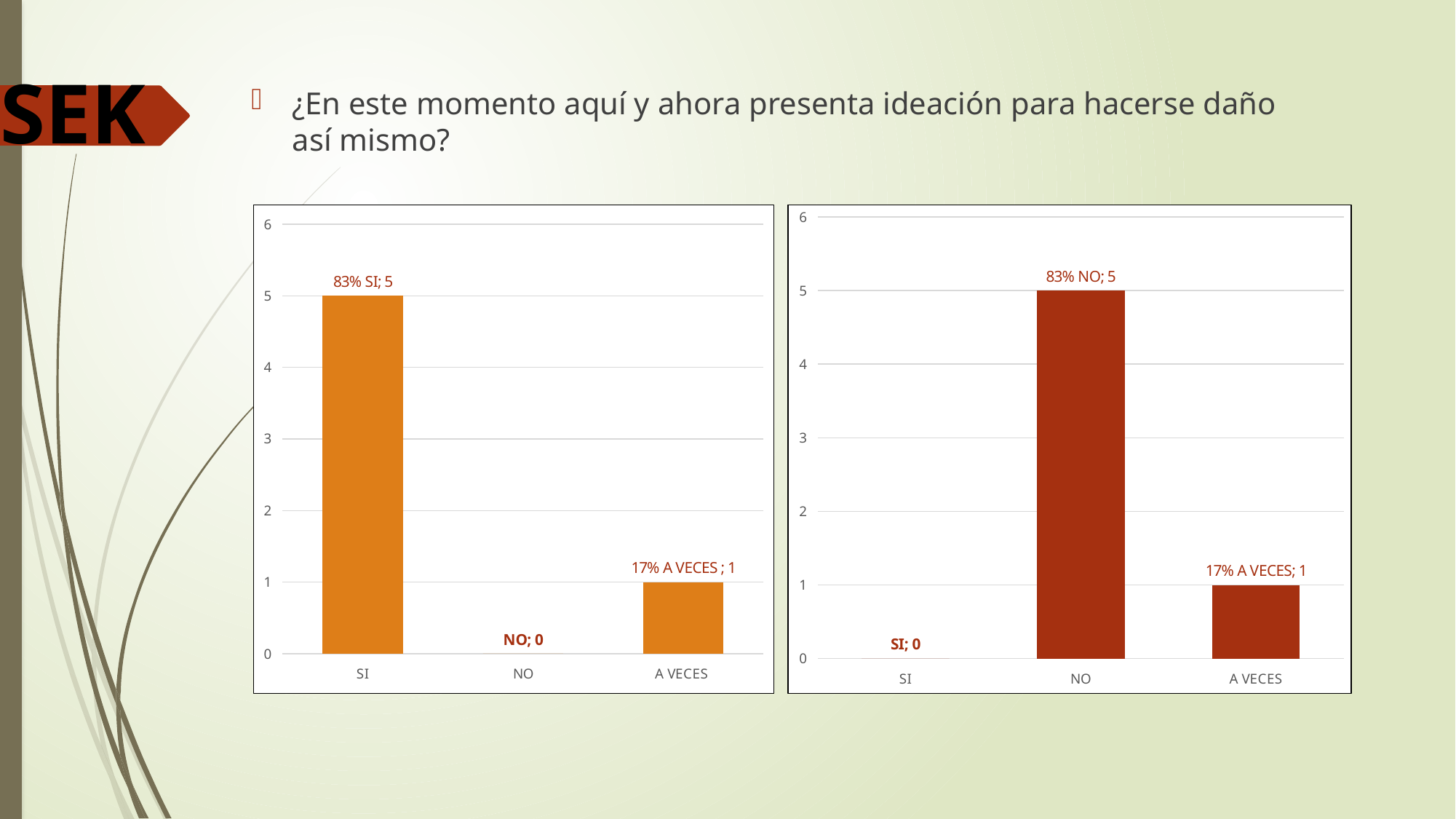
In the left chart, what is the value for A VECES? 1 In the right chart, which category has the lowest value? SI In the left chart, which category has the highest value? SI In the left chart, what is the value for SI? 5 What kind of chart is the left chart? bar chart In the left chart, what is the difference between the values for SI and A VECES? 4 How many categories are shown on the x axis of the right chart? 3 What colour are the bars in the right chart? dark red In the right chart, what is the value for SI? 0 In the left chart, what percentage is shown in the data label for SI? 83% In the right chart, which is larger, the value for NO or the value for A VECES? NO In the right chart, what is the value for NO? 5